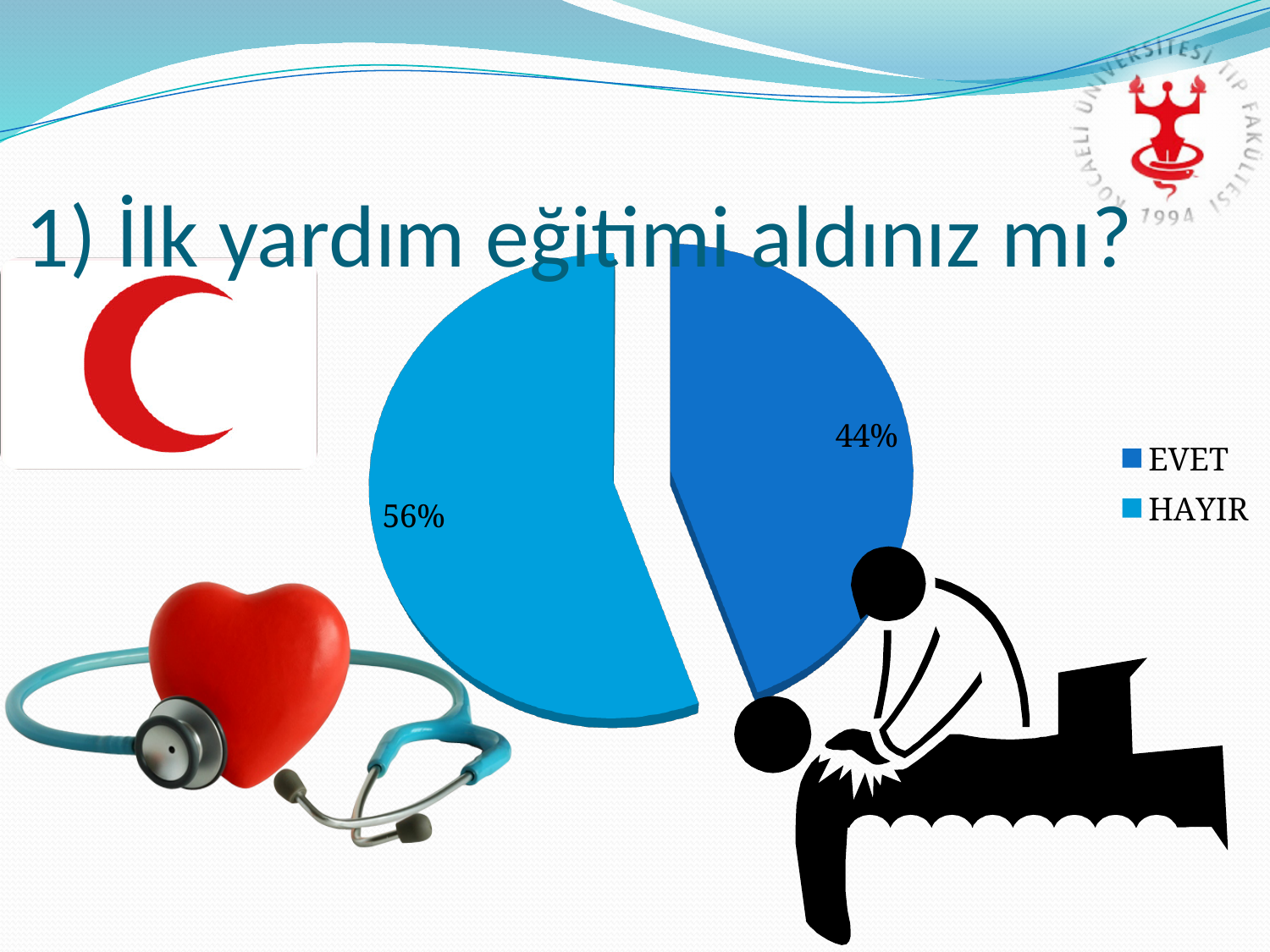
Which slice of the pie is the largest? HAYIR What is the difference in percentage points between the HAYIR and EVET slices? 12% What kind of chart is shown on the slide? pie chart What is the total of the two pie slice percentages? 100% Which is larger, the EVET slice or the HAYIR slice? HAYIR What share of the pie is labelled EVET? 44% Which legend entry is shown in the lighter blue colour? HAYIR Which slice of the pie is the smallest? EVET How many slices does the pie chart have? 2 What share of the pie is labelled HAYIR? 56% What question does the slide title ask about the chart? 1) İlk yardım eğitimi aldınız mı? How many entries does the legend list? 2